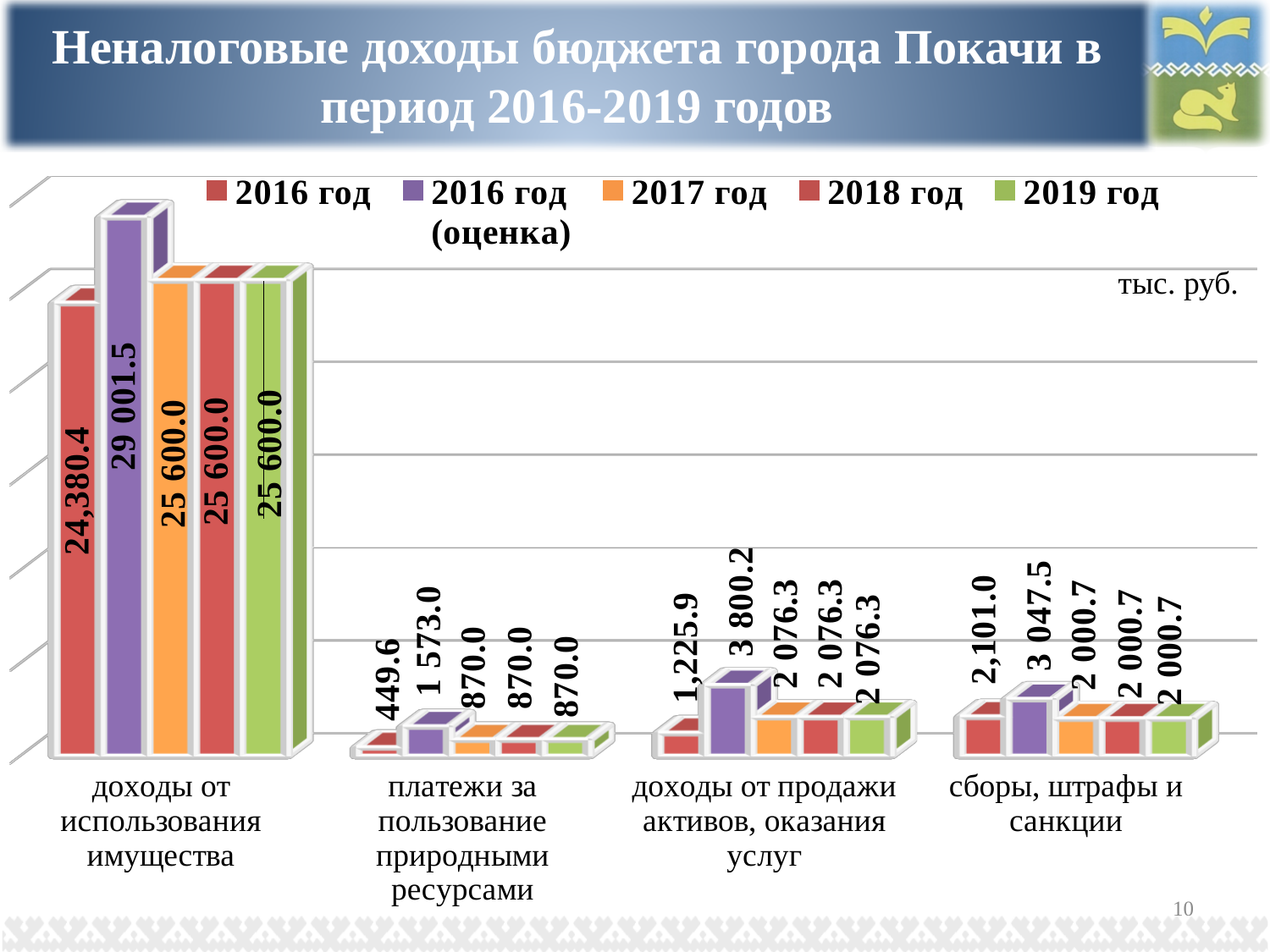
What is the value for 2017 год in the category 'платежи за пользование природными ресурсами'? 870.0 What is the difference between the 2016 год (оценка) value and the 2017 год value in the category 'доходы от использования имущества'? 3 401.5 How many series does the legend list? 5 Which is larger in the category 'сборы, штрафы и санкции': the value for 2016 год or the value for 2016 год (оценка)? 2016 год (оценка) What type of chart is shown on the slide? bar chart What unit of measurement is indicated on the chart? тыс. руб. How many categories are shown on the x axis? 4 Which category has the highest value for 2016 год (оценка)? доходы от использования имущества What is the value for 2016 год in the category 'доходы от продажи активов, оказания услуг'? 1,225.9 What is the value for 2019 год in the category 'сборы, штрафы и санкции'? 2 000.7 What is the value for 2016 год (оценка) in the category 'доходы от использования имущества'? 29 001.5 Which category has the lowest value for 2016 год? платежи за пользование природными ресурсами